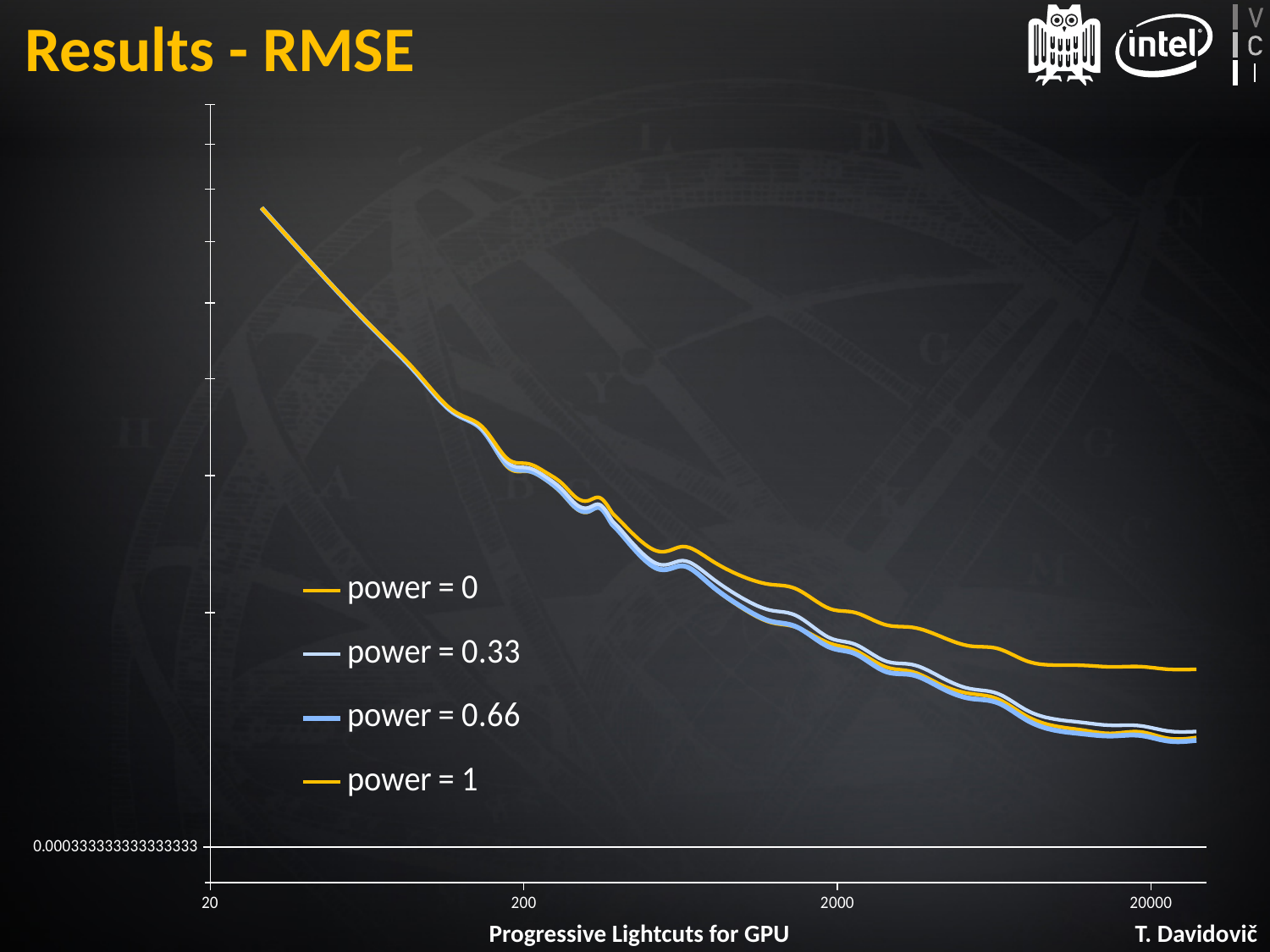
What kind of chart is shown on the slide? line chart What is the rightmost tick label on the x axis? 20000 What is the only value labelled on the y axis? 0.000333333333333333 How many tick labels are shown on the x axis? 4 Do the plotted values rise or fall as the x axis increases? fall What are the four legend entries of the chart? power = 0, power = 0.33, power = 0.66, power = 1 How many series does the legend list? 4 Which x-axis tick label comes immediately after 200? 2000 What is the leftmost tick label on the x axis? 20 At the right end of the chart (around x = 20000), are the plotted lines greater or less than 0.000333333333333333? greater What is the title of the slide containing the chart? Results - RMSE